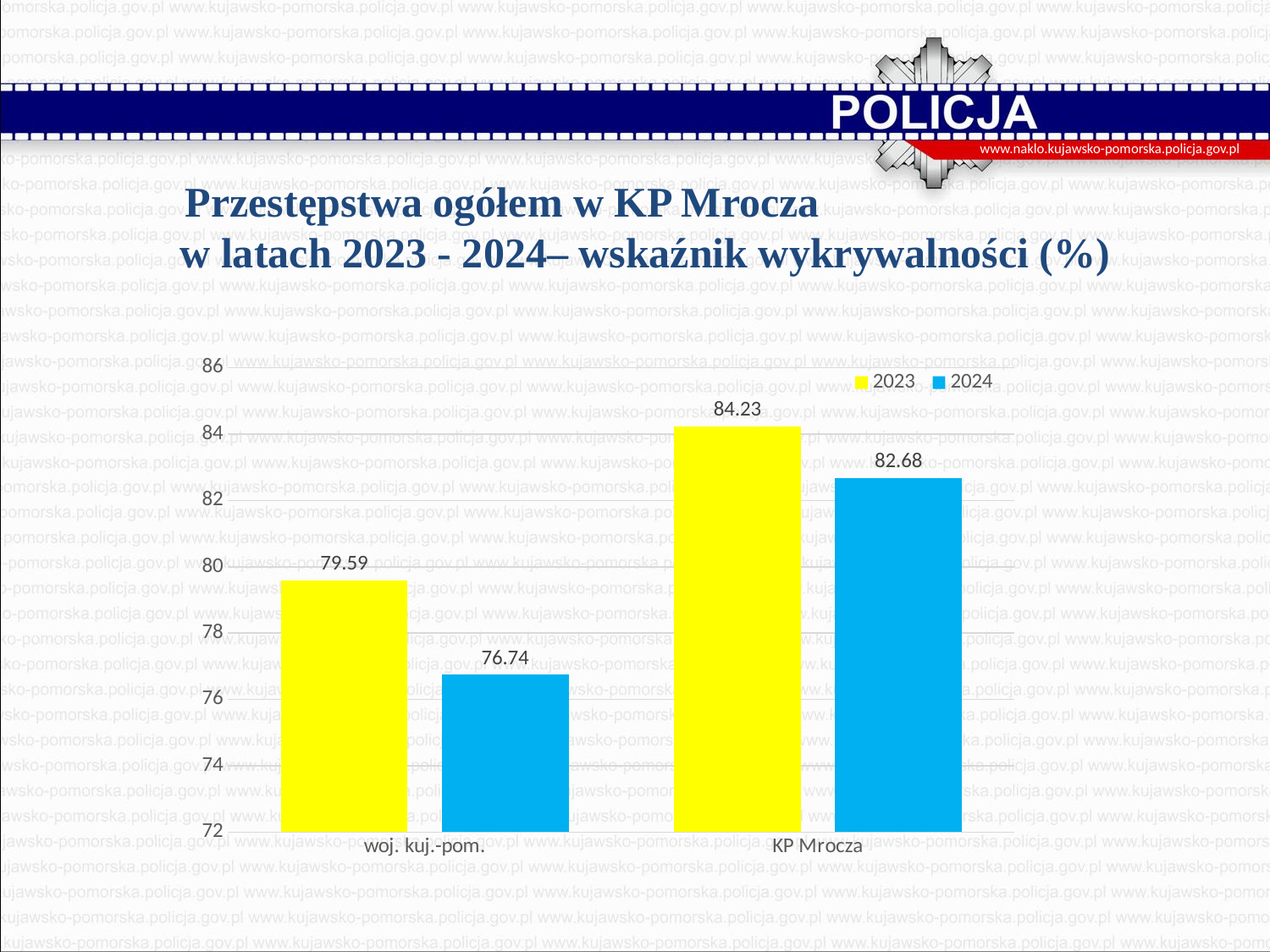
Which is larger: the 2024 value for KP Mrocza or the 2023 value for woj. kuj.-pom.? 2024 value for KP Mrocza What is the difference between the 2023 and 2024 values for KP Mrocza? 1.55 Which category has the highest 2023 value? KP Mrocza What kind of chart is shown on the slide? bar chart How many series does the legend list? 2 Which bar shows the lowest value on the chart? woj. kuj.-pom. 2024 What is the difference between the 2023 and 2024 values for woj. kuj.-pom.? 2.85 What is the 2023 value for woj. kuj.-pom.? 79.59 What is the 2024 value for woj. kuj.-pom.? 76.74 How many categories are shown on the x axis? 2 What is the 2023 value for KP Mrocza? 84.23 What is the 2024 value for KP Mrocza? 82.68